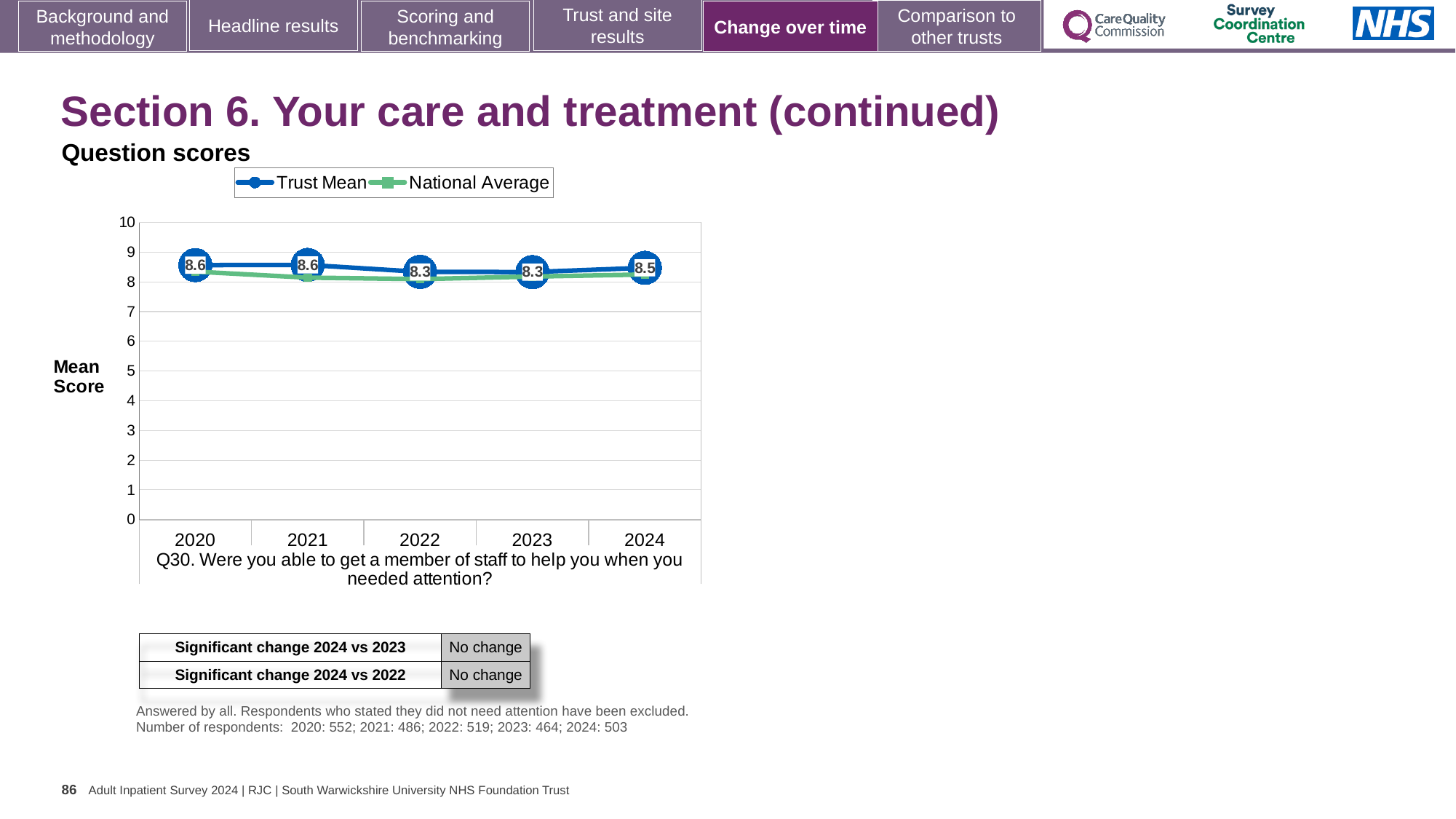
Is the National Average value for 2020 greater or less than 7? greater What kind of chart is shown on the slide? Line chart How many series does the chart legend list? 2 What is the Trust Mean score for 2023? 8.3 How many years are shown on the x axis of the chart? 5 What is the difference between the Trust Mean scores for 2024 and 2023? 0.2 What is the Trust Mean score for 2024? 8.5 Does the Trust Mean score rise or fall from 2021 to 2022? Fall What is the Trust Mean score for 2022? 8.3 Which year has the larger Trust Mean score, 2021 or 2022? 2021 What is the Trust Mean score for 2020? 8.6 What is the label on the y axis of the chart? Mean Score